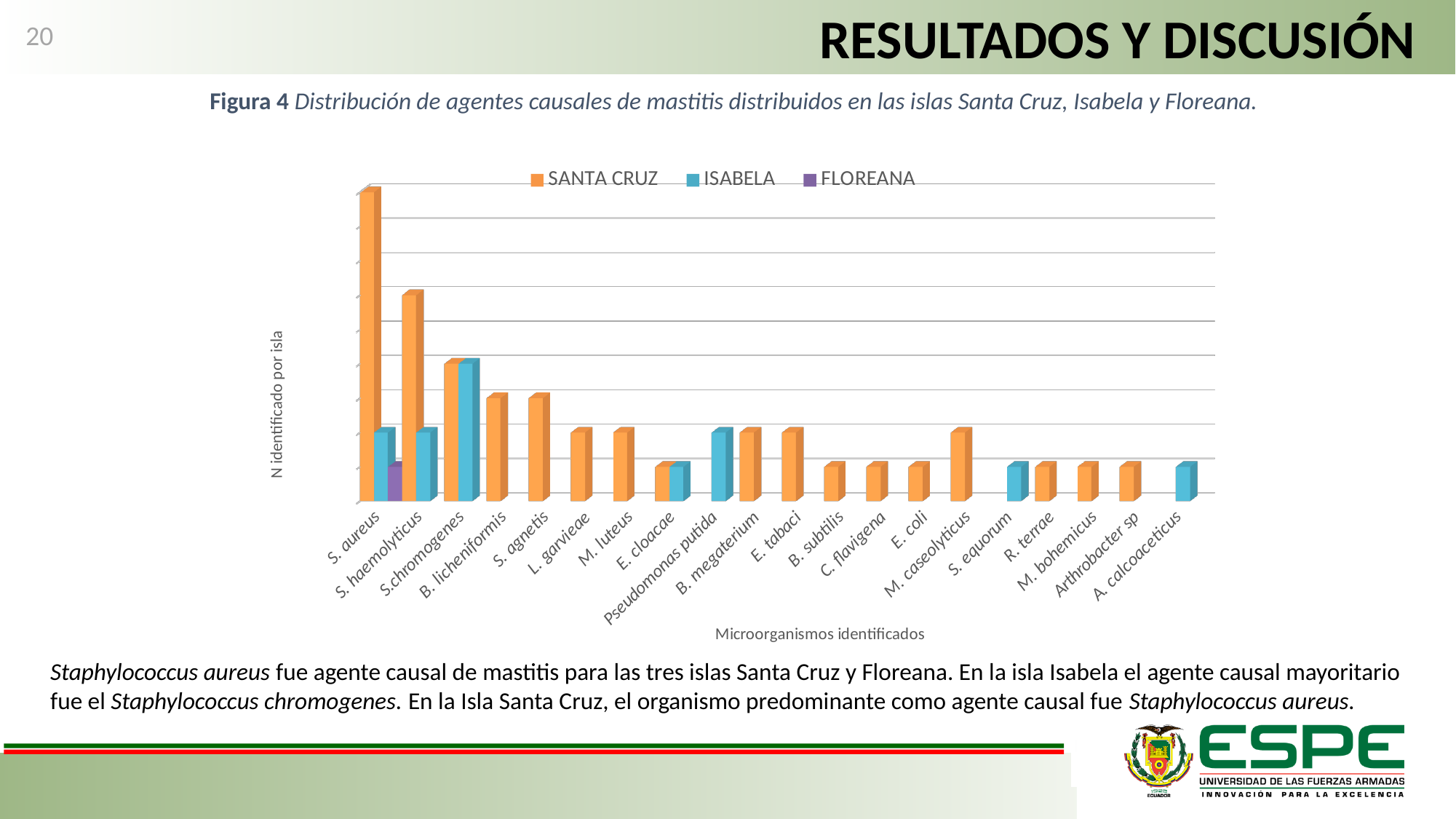
For SANTA CRUZ, which is larger: S. aureus or S. haemolyticus? S. aureus Do the SANTA CRUZ bars generally rise or fall from left to right along the x axis? Fall How many series does the legend list? 3 Which microorganism has the highest value for ISABELA? S.chromogenes What kind of chart is shown on the slide? Bar chart Which microorganism is the only one with a FLOREANA bar? S. aureus For ISABELA, which is larger: S. chromogenes or S. aureus? S.chromogenes Which microorganism has the highest value for SANTA CRUZ? S. aureus What is the title of the x axis? Microorganismos identificados How many microorganisms have an ISABELA bar? 7 How many microorganism categories are shown on the x axis? 20 Which series are listed in the legend? SANTA CRUZ, ISABELA, FLOREANA